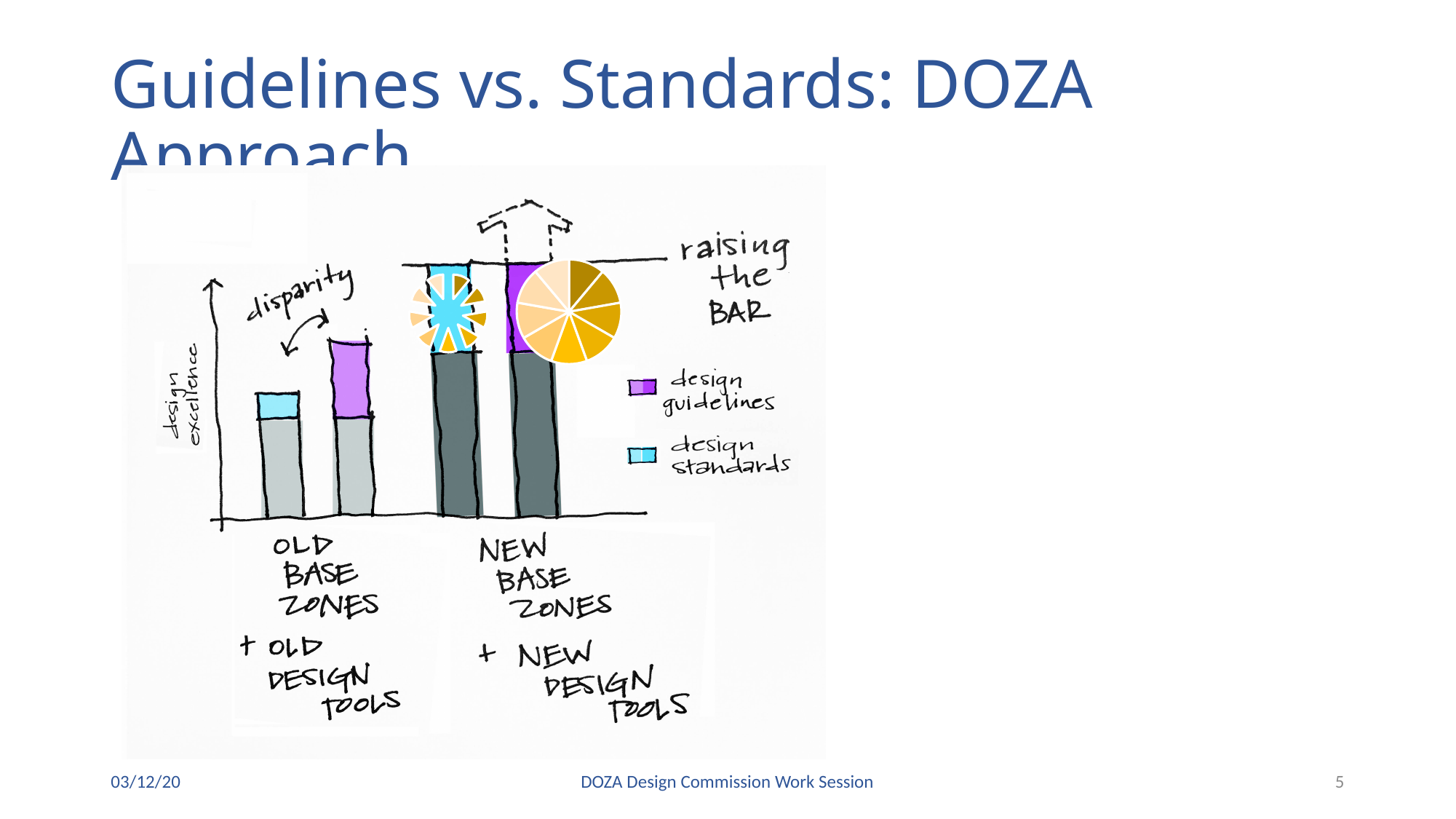
What kind of chart is shown in the sketch on the slide? bar chart How many category groups are labelled along the x axis of the sketch chart? 2 Do the bar heights rise or fall moving from the OLD BASE ZONES group to the NEW BASE ZONES group along the x axis? rise What annotation is written next to the dashed line at the top of the NEW BASE ZONES bars? raising the BAR In the OLD BASE ZONES group, which bar is taller, the design standards bar or the design guidelines bar? design guidelines How many bars are drawn in the sketch chart? 4 Which category group has the taller bars, OLD BASE ZONES + OLD DESIGN TOOLS or NEW BASE ZONES + NEW DESIGN TOOLS? NEW BASE ZONES + NEW DESIGN TOOLS How many series does the legend of the sketch chart list? 2 Which series does the purple colour represent in the sketch chart's legend? design guidelines